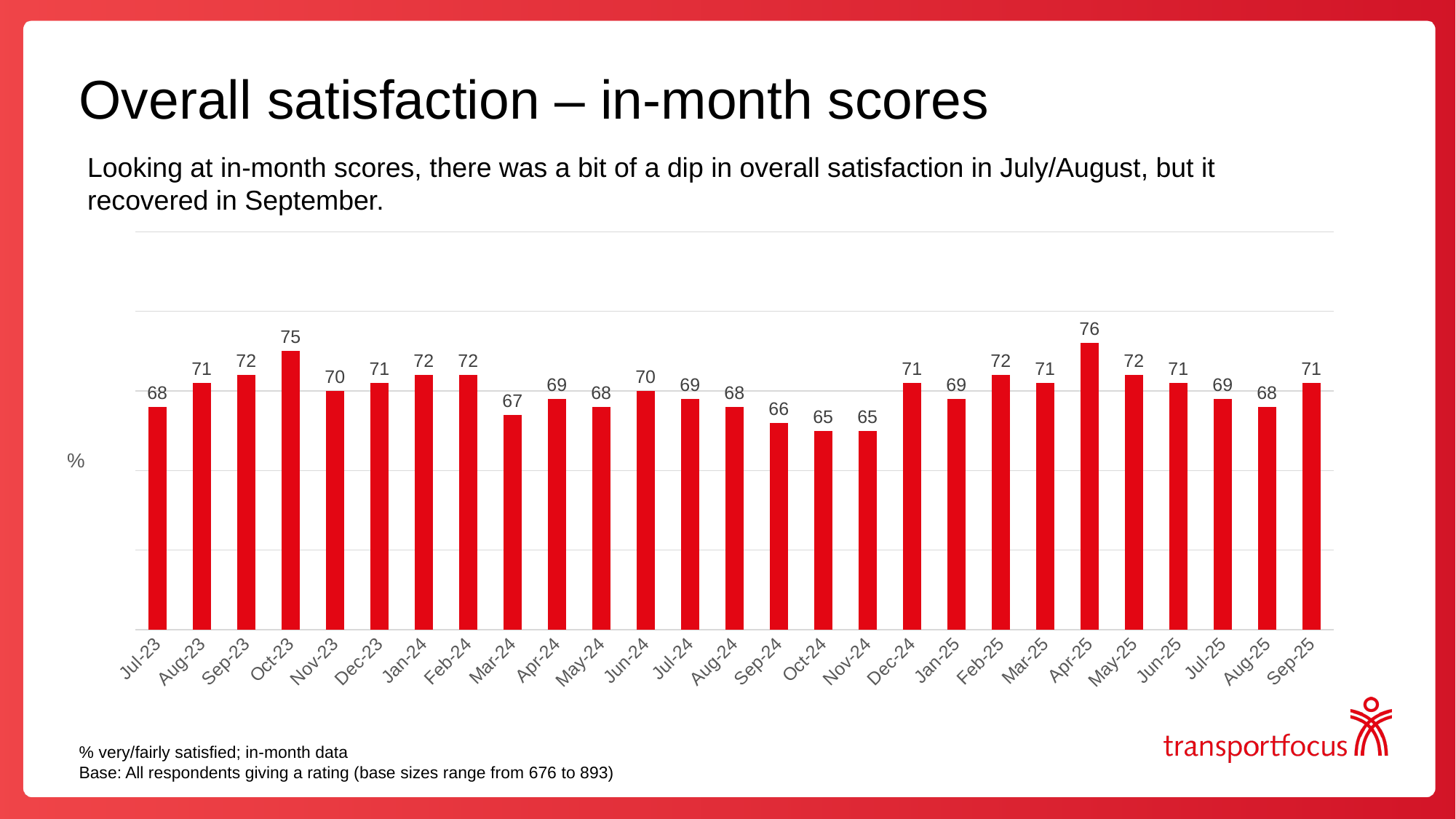
What is the overall satisfaction score for Oct-23? 75 What is the difference between the scores for Apr-25 and Aug-25? 8 Do the scores rise or fall from Jul-25 to Aug-25? Fall What is the overall satisfaction score for Sep-24? 66 What is the difference between the scores for Oct-23 and Nov-23? 5 How many months are shown on the chart? 27 What is the overall satisfaction score for Sep-25? 71 What kind of chart is shown on the slide? Bar chart Which month has the highest overall satisfaction score? Apr-25 Which is larger, the score for Dec-24 or the score for Nov-24? Dec-24 Which is larger, the score for Feb-25 or the score for Jan-25? Feb-25 What is the overall satisfaction score for Mar-24? 67